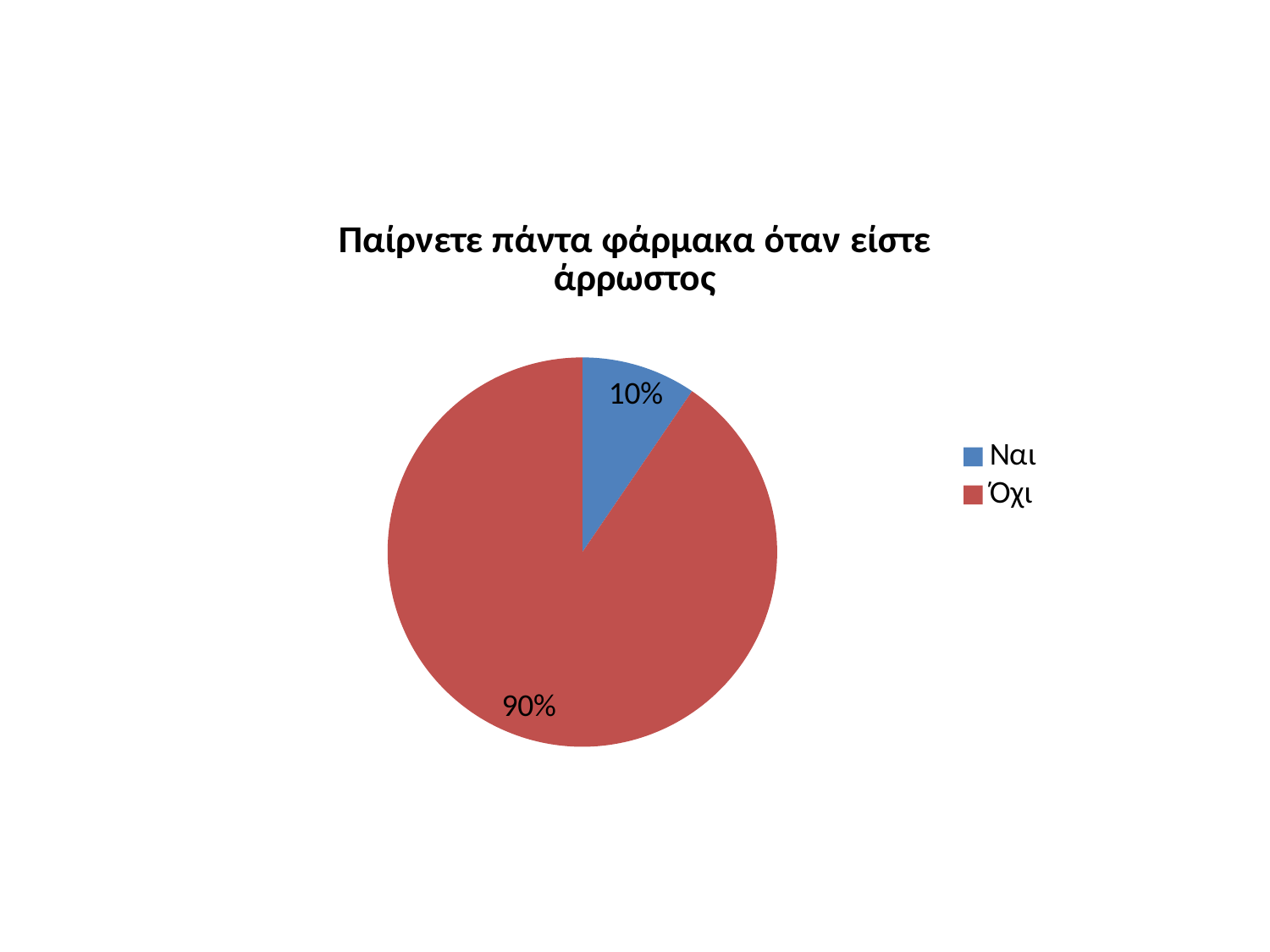
How many slices does the pie chart have? 2 What percentage of the pie is labelled for Όχι? 90% What colour is the slice for Ναι? blue Which is larger, the share for Ναι or the share for Όχι? Όχι Which category has the largest share of the pie? Όχι What is the difference in percentage points between Όχι and Ναι? 80 What share of the pie does Όχι represent? 90% How many entries does the legend list? 2 What kind of chart is shown on the slide? pie chart What is the title of the chart? Παίρνετε πάντα φάρμακα όταν είστε άρρωστος Which category has the smallest share of the pie? Ναι What percentage of the pie is labelled for Ναι? 10%